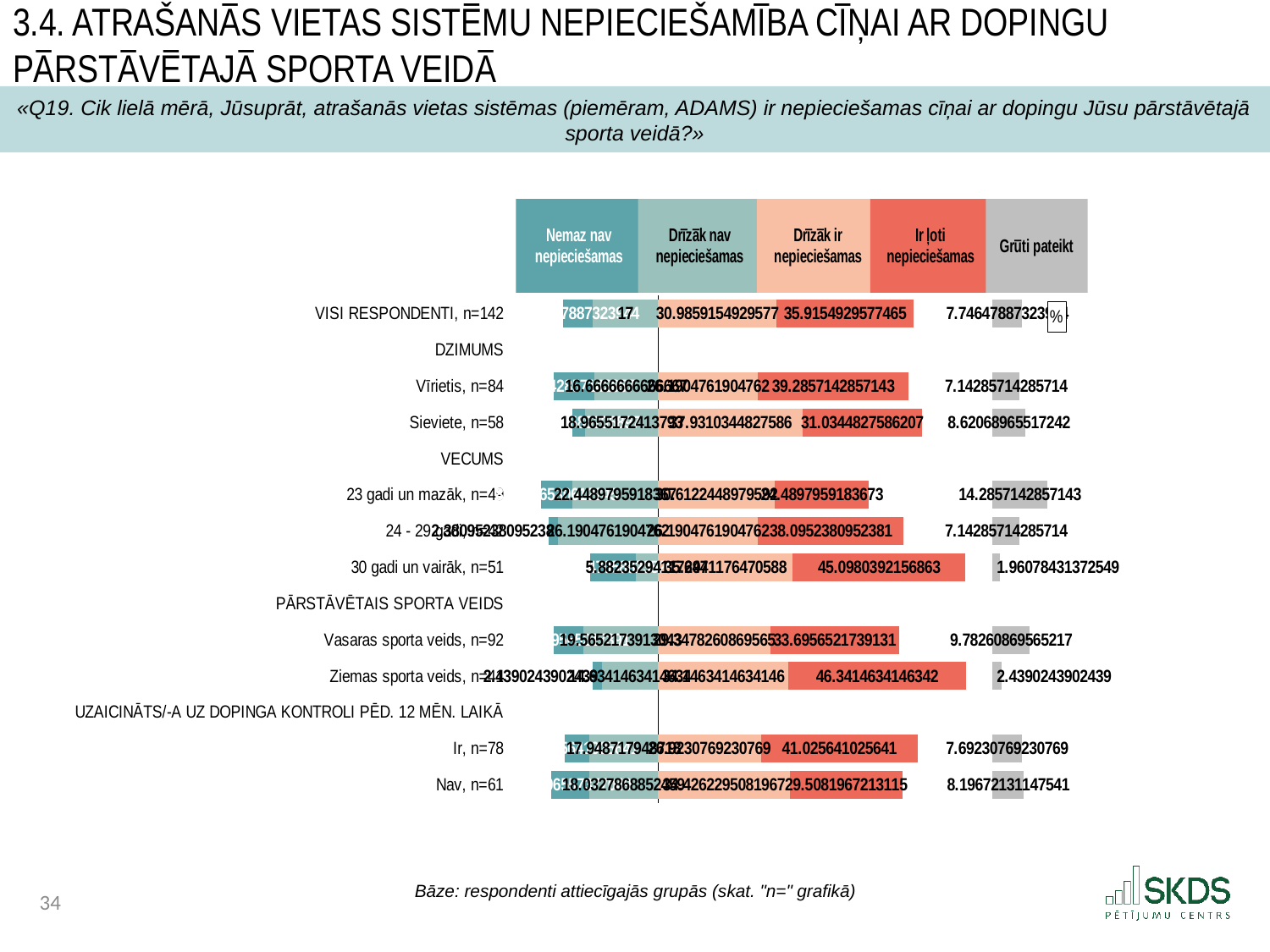
What kind of chart is shown on the slide? Stacked bar chart Which respondent group has the lowest "Grūti pateikt" value? 30 gadi un vairāk, n=51 Which has the larger "Ir ļoti nepieciešamas" value, "Vīrietis, n=84" or "Sieviete, n=58"? Vīrietis, n=84 What is the value of "Grūti pateikt" for "VISI RESPONDENTI, n=142"? 7.74647887323 How many series does the legend list? 5 Which respondent group has the highest "Grūti pateikt" value? 23 gadi un mazāk What is the value of "Ir ļoti nepieciešamas" for "Vīrietis, n=84"? 39.2857142857143 What is the value of "Ir ļoti nepieciešamas" for "Ziemas sporta veids"? 46.3414634146342 What is the value of "Grūti pateikt" for "23 gadi un mazāk"? 14.2857142857143 What is the value of "Ir ļoti nepieciešamas" for "Sieviete, n=58"? 31.0344827586207 What is the value of "Grūti pateikt" for "30 gadi un vairāk, n=51"? 1.96078431372549 Which legend entry is shown in red? Ir ļoti nepieciešamas